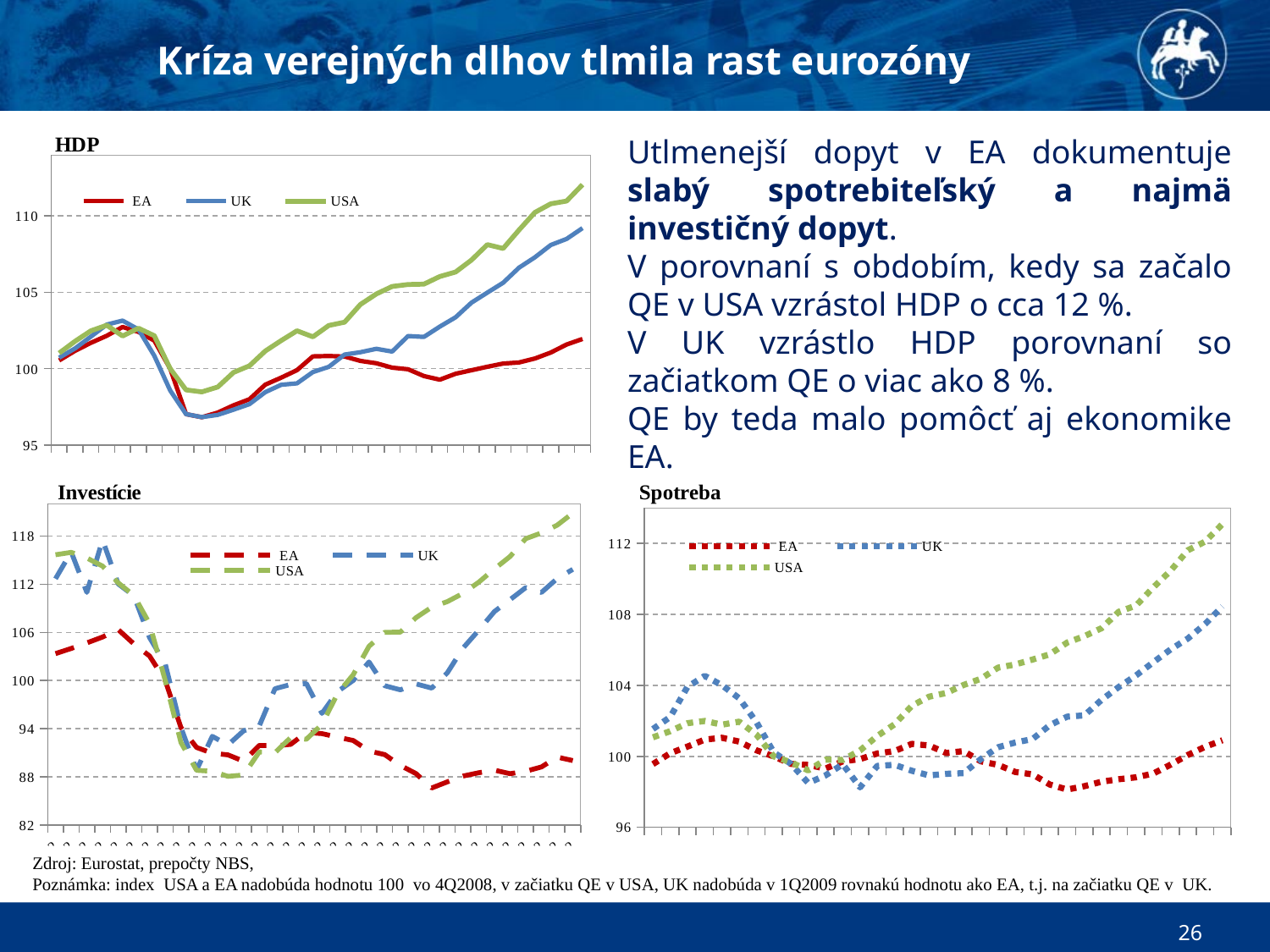
Which series are listed in the legend of the Spotreba chart? EA, UK, USA In the HDP chart, which series has the highest value at the right end of the chart? USA How many series does the legend of the Investície chart list? 3 In the Spotreba chart, is the final value of the USA series greater or less than 112? greater In the Investície chart, is the final value of the EA series greater or less than 94? less What kind of chart is the HDP chart? line chart In the Investície chart, which series ends higher at the right end, USA or UK? USA In the HDP chart, which series has the lowest value at the right end of the chart? EA In the HDP chart, is the final value of the EA series greater or less than 105? less In the Investície chart, does the EA series overall rise or fall from the left end to the right end? fall In the Spotreba chart, which series ends lower at the right end, EA or UK? EA